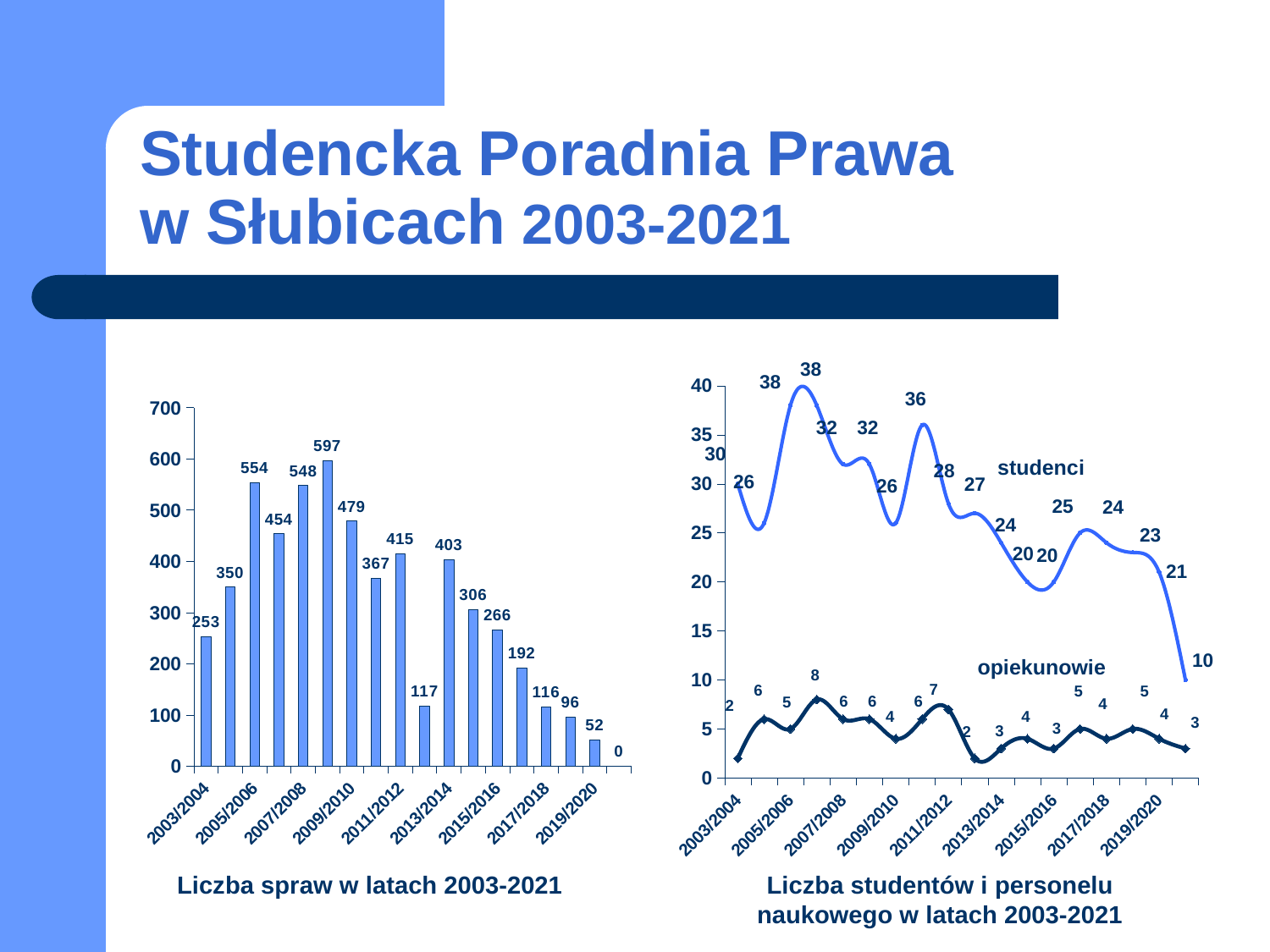
In the left chart 'Liczba spraw w latach 2003-2021', what is the difference between the values for 2005/2006 and 2003/2004? 301 In the right chart 'Liczba studentów i personelu naukowego w latach 2003-2021', what is the lowest value of the 'studenci' series? 10 In the left chart 'Liczba spraw w latach 2003-2021', what is the highest value shown? 597 How many series are plotted in the right chart 'Liczba studentów i personelu naukowego w latach 2003-2021'? 2 In the right chart 'Liczba studentów i personelu naukowego w latach 2003-2021', what is the highest value of the 'studenci' series? 38 In the left chart 'Liczba spraw w latach 2003-2021', what is the value for 2003/2004? 253 In the left chart 'Liczba spraw w latach 2003-2021', which is larger: the value for 2007/2008 or for 2009/2010? 2007/2008 In the right chart 'Liczba studentów i personelu naukowego w latach 2003-2021', what is the 'studenci' value for 2003/2004? 30 In the right chart 'Liczba studentów i personelu naukowego w latach 2003-2021', what is the highest value of the 'opiekunowie' series? 8 What kind of chart is the left chart, 'Liczba spraw w latach 2003-2021'? bar chart In the left chart 'Liczba spraw w latach 2003-2021', what is the lowest value shown? 0 How many bars are plotted in the left chart 'Liczba spraw w latach 2003-2021'? 18